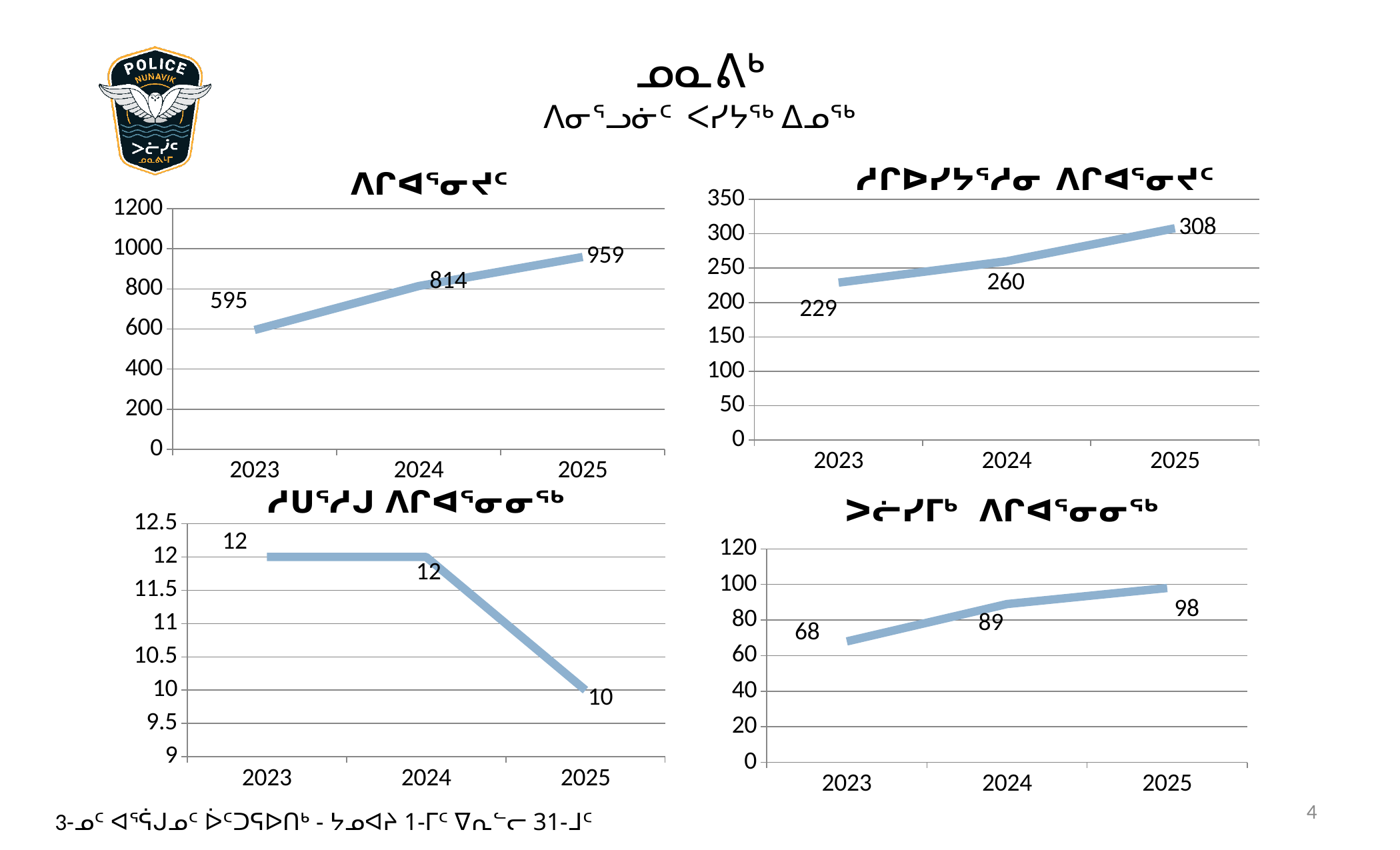
In the top-right chart, which year has the highest value? 2025 In the top-left chart, do the values rise or fall from 2023 to 2025? rise In the top-left chart, what is the value for 2025? 959 In the bottom-left chart, which year has the lowest value? 2025 In the bottom-right chart, is the value for 2024 larger or smaller than the value for 2025? smaller In the bottom-left chart, what is the value for 2025? 10 How many charts are on the slide, and what type are they? 4 line charts In the bottom-right chart, what is the value for 2023? 68 In the top-right chart, what is the difference between the 2025 and 2024 values? 48 In the top-left chart, what is the difference between the 2025 and 2023 values? 364 In the top-right chart, what is the value for 2024? 260 In the bottom-left chart, do the values rise or fall from 2024 to 2025? fall